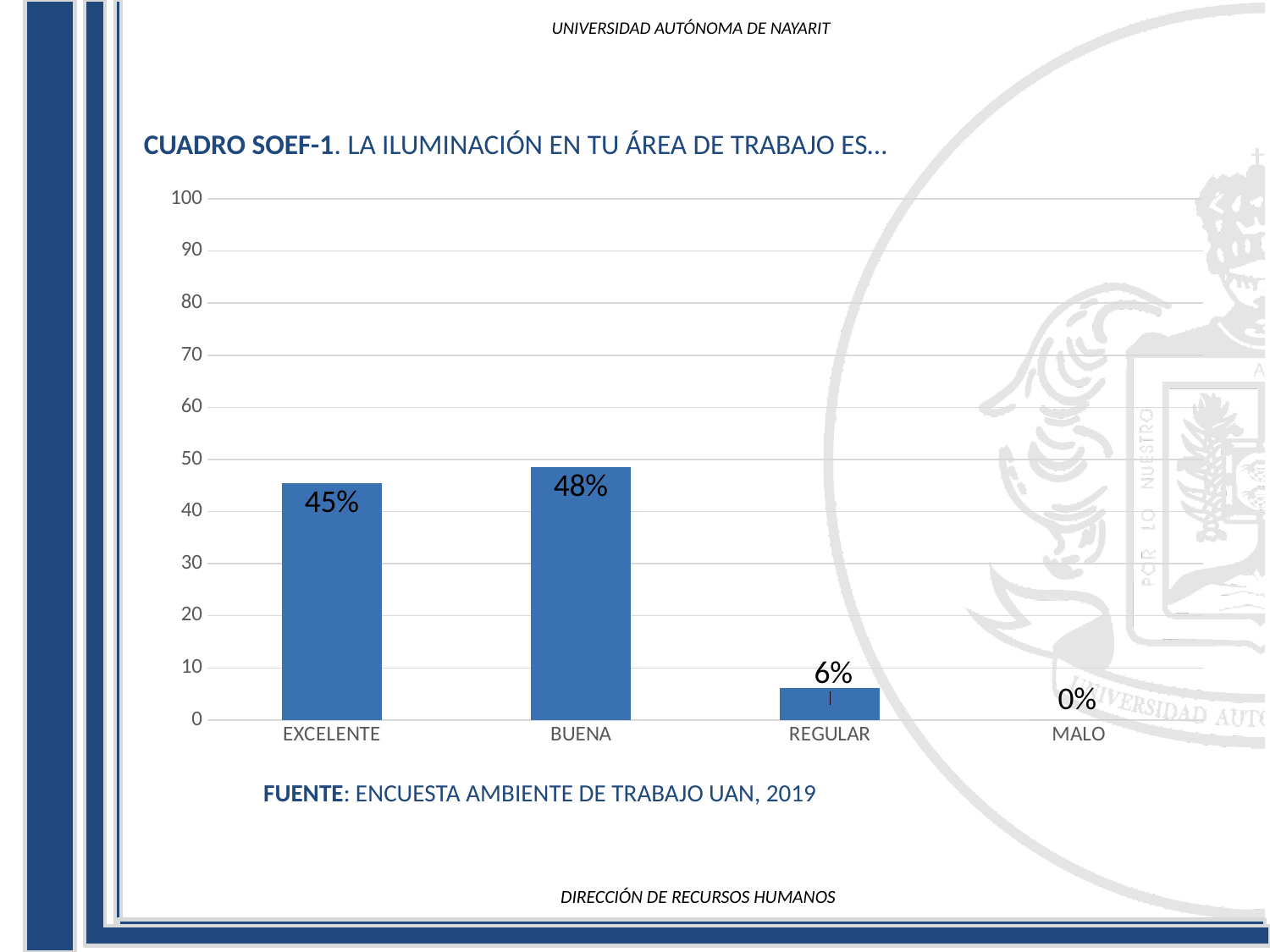
How many categories are shown on the x axis? 4 What is the value for MALO? 0% What is the value for BUENA? 48% Which category has the lowest value? MALO What is the title of the chart? CUADRO SOEF-1. LA ILUMINACIÓN EN TU ÁREA DE TRABAJO ES… What kind of chart is shown on the slide? Bar chart What is the difference between the values for BUENA and EXCELENTE? 3% Which is larger, the value for EXCELENTE or the value for REGULAR? EXCELENTE What is the value for EXCELENTE? 45% Which category has the highest value? BUENA What is the difference between the values for EXCELENTE and REGULAR? 39% What is the value for REGULAR? 6%